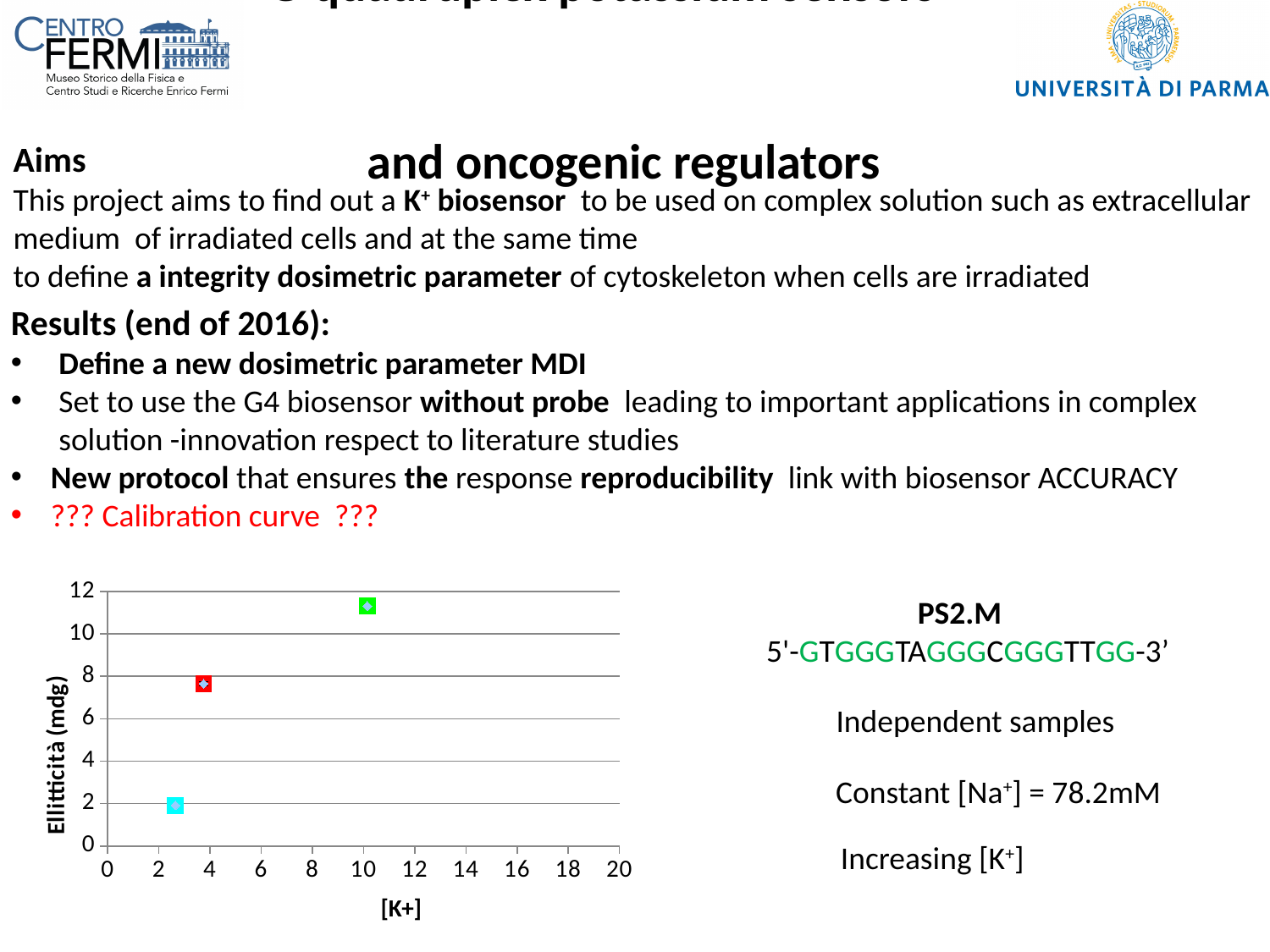
Is the Ellitticità value of the cyan point greater or less than 4? less Is the Ellitticità value of the green point greater or less than 10? greater What is the label of the y axis of the chart? Ellitticità (mdg) Which coloured point has the highest Ellitticità value? the green point What is the label of the x axis of the chart? [K+] Does Ellitticità rise or fall as [K+] increases along the x axis? rises Is the [K+] value of the green point greater or less than 8? greater Which has the larger Ellitticità value, the red point or the cyan point? the red point What kind of chart is shown on the slide? scatter chart Which coloured point has the lowest Ellitticità value? the cyan point How many data points are plotted on the chart? 3